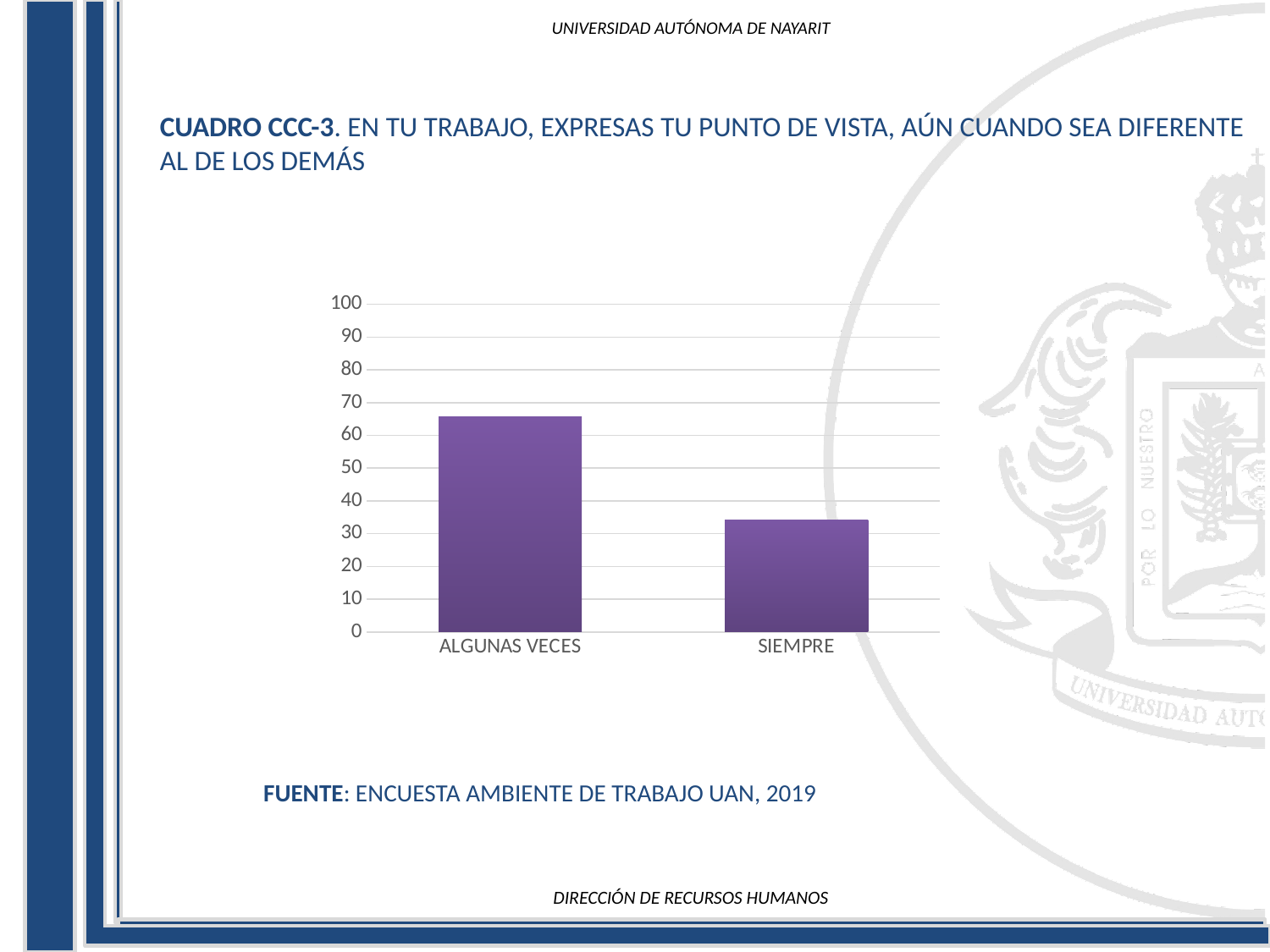
Is the value for SIEMPRE greater or less than 40? less Which category has the lowest bar? SIEMPRE How many categories are shown on the x axis of the chart? 2 What is the maximum value shown on the vertical axis of the chart? 100 What is the source cited below the chart? ENCUESTA AMBIENTE DE TRABAJO UAN, 2019 Which is larger, the value for ALGUNAS VECES or the value for SIEMPRE? ALGUNAS VECES Is the value for SIEMPRE greater or less than 30? greater Which category has the highest bar? ALGUNAS VECES Is the value for ALGUNAS VECES greater or less than 70? less What kind of chart is shown on the slide? bar chart